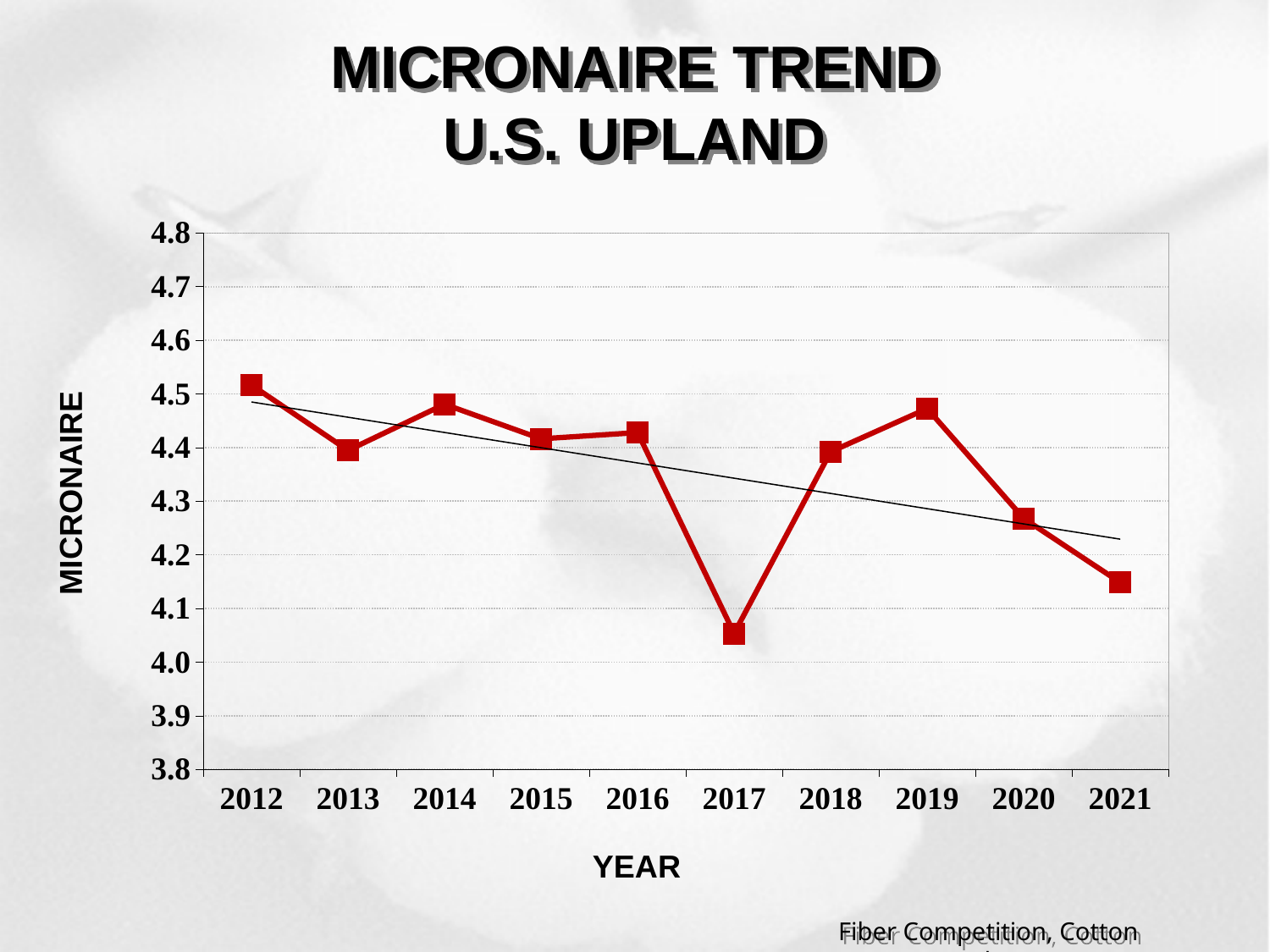
What is the label on the vertical axis of the chart? MICRONAIRE Which year has the lowest micronaire value? 2017 Is the micronaire value for 2017 greater or less than 4.1? less How many years are plotted on the x axis? 10 Which year has the higher micronaire value, 2017 or 2018? 2018 What kind of chart is shown on the slide? line chart Is the micronaire value for 2021 greater or less than 4.2? less Which year has the highest micronaire value? 2012 Does the micronaire value generally rise or fall from 2012 to 2021? fall Which year has the higher micronaire value, 2019 or 2020? 2019 Is the micronaire value for 2019 greater or less than 4.4? greater